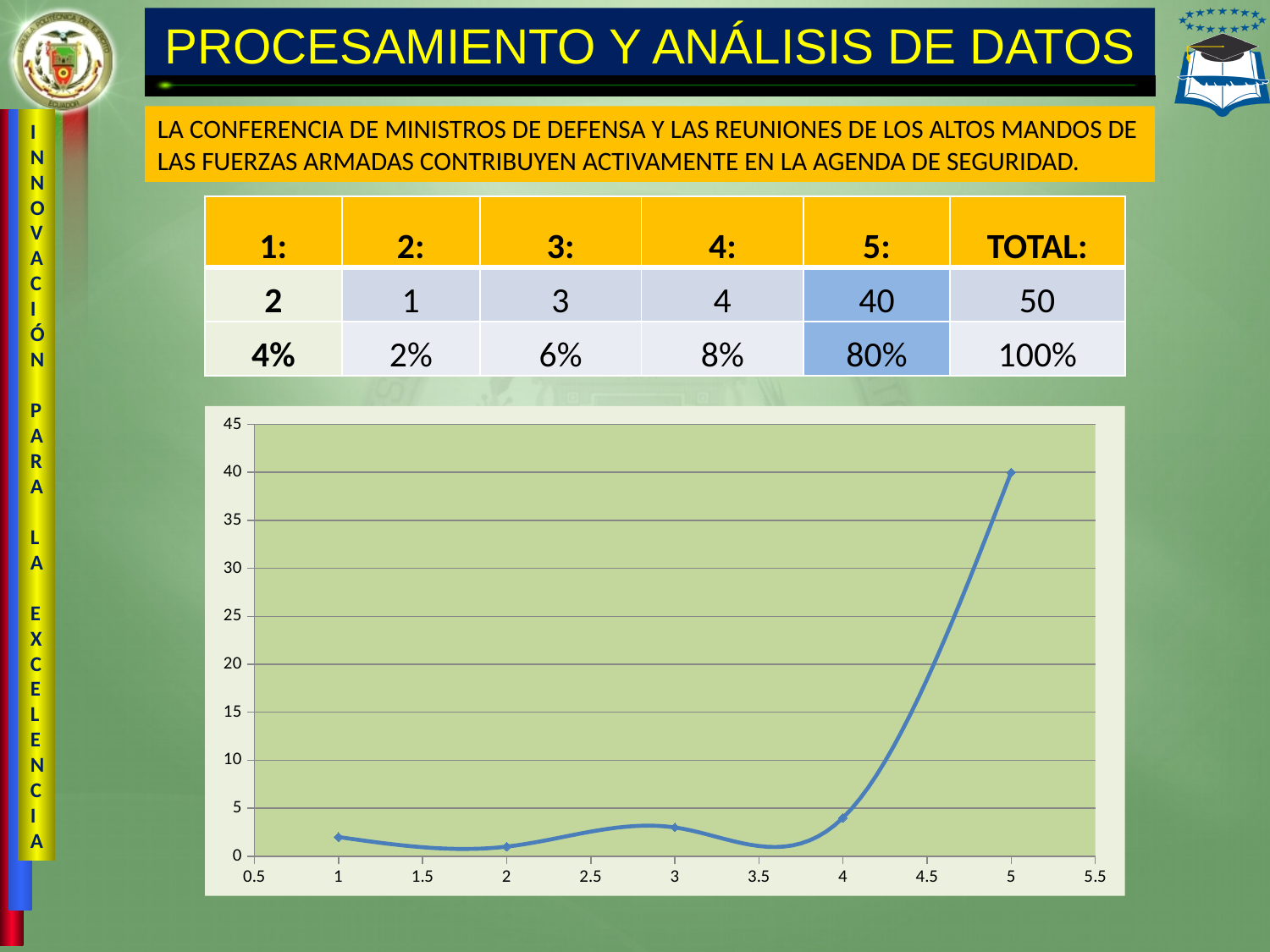
What is the value of the point plotted at x = 5? 40 How many data points are plotted on the chart? 5 At which x value does the chart reach its highest point? 5 Is the value of the point at x = 5 greater or less than 35? greater What kind of chart is shown on the slide? line chart Does the line rise or fall between x = 4 and x = 5? rise Is the value of the point at x = 4 greater or less than 5? less Is the value of the point at x = 3 greater or less than 10? less What is the difference between the value at x = 5 (40) and the value at x = 4 (4)? 36 Which point has the larger value, the one at x = 5 or the one at x = 1? x = 5 At which x value does the chart reach its lowest point? 2 What is the highest value shown on the chart's vertical axis? 45